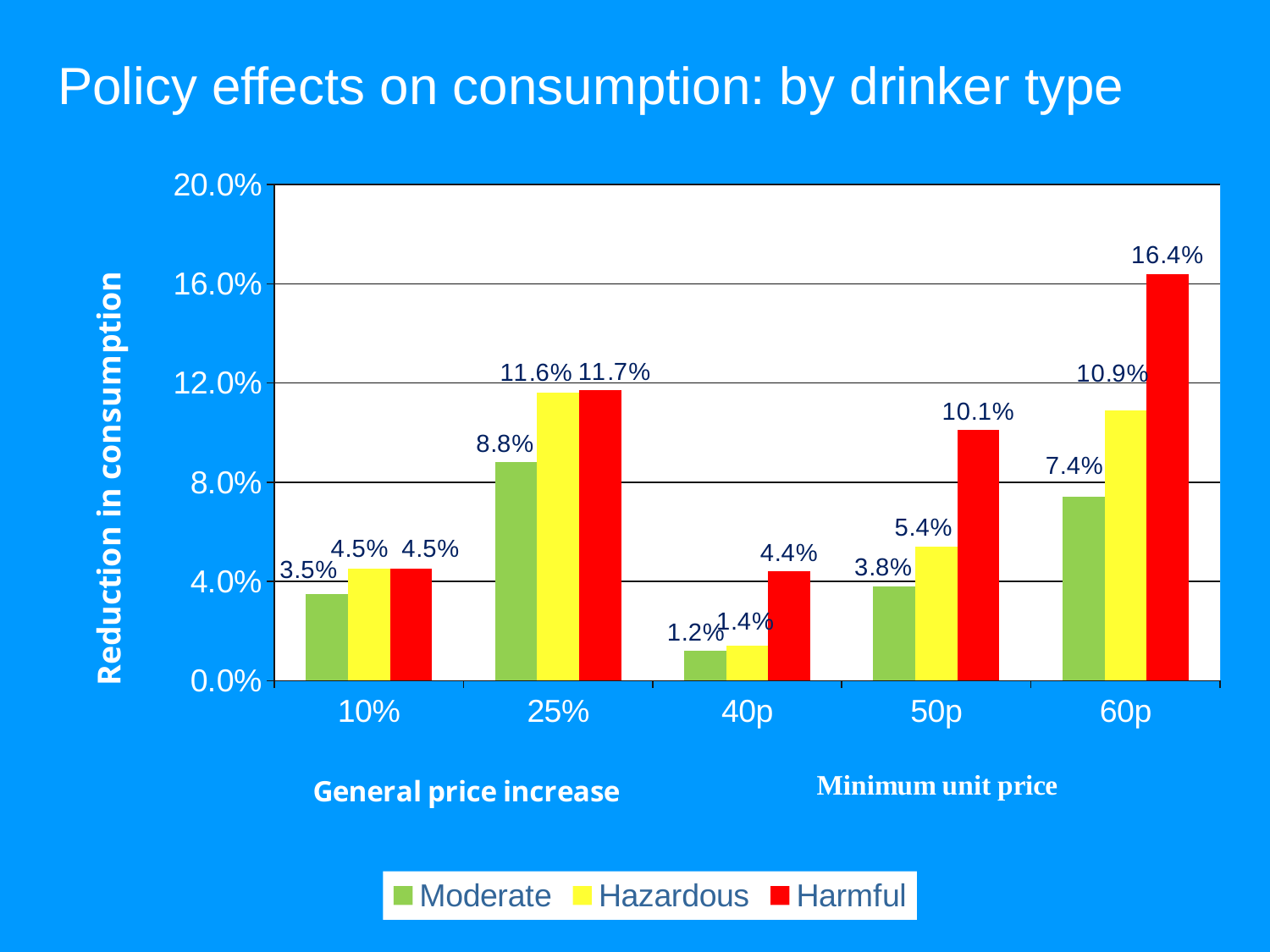
Which category has the highest reduction in consumption for Harmful drinkers? 60p How many series does the legend list? 3 What is the reduction in consumption for Hazardous drinkers at 50p? 5.4% What is the reduction in consumption for Harmful drinkers at 60p? 16.4% Which category has the lowest reduction in consumption for Moderate drinkers? 40p How many categories are shown on the x axis? 5 Is the Harmful reduction at 50p greater or less than 8.0%? greater What is the difference between the Harmful and Moderate reductions at 60p? 9.0% Which is larger: the Hazardous reduction at 25% or the Hazardous reduction at 60p? Hazardous at 25% What is the reduction in consumption for Moderate drinkers at 25%? 8.8% What is the title of the chart? Policy effects on consumption: by drinker type What kind of chart is shown on the slide? bar chart